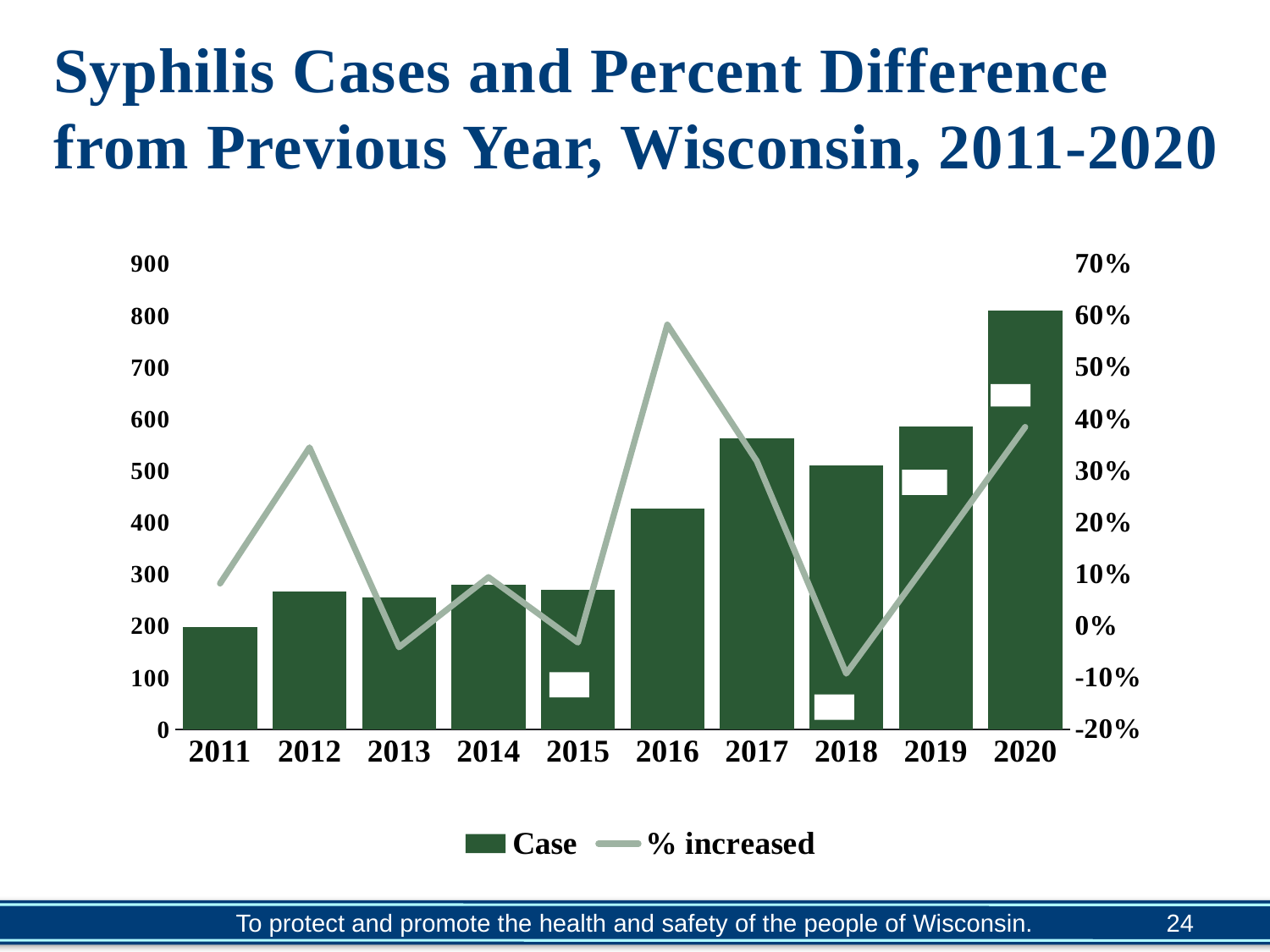
How many series does the legend list? 2 Which year has the lowest number of syphilis cases? 2011 Is the number of cases in 2020 greater or less than 700? greater Is the % increased value for 2016 greater or less than 50%? greater How many years are shown on the x axis? 10 Is the number of cases in 2011 greater or less than 300? less Which year has the highest number of syphilis cases? 2020 In which year does the % increased line reach its lowest point? 2018 Were there more syphilis cases in 2017 or in 2018? 2017 Overall, do syphilis cases rise or fall from 2011 to 2020? rise Were there more syphilis cases in 2016 or in 2015? 2016 In which year does the % increased line reach its highest point? 2016